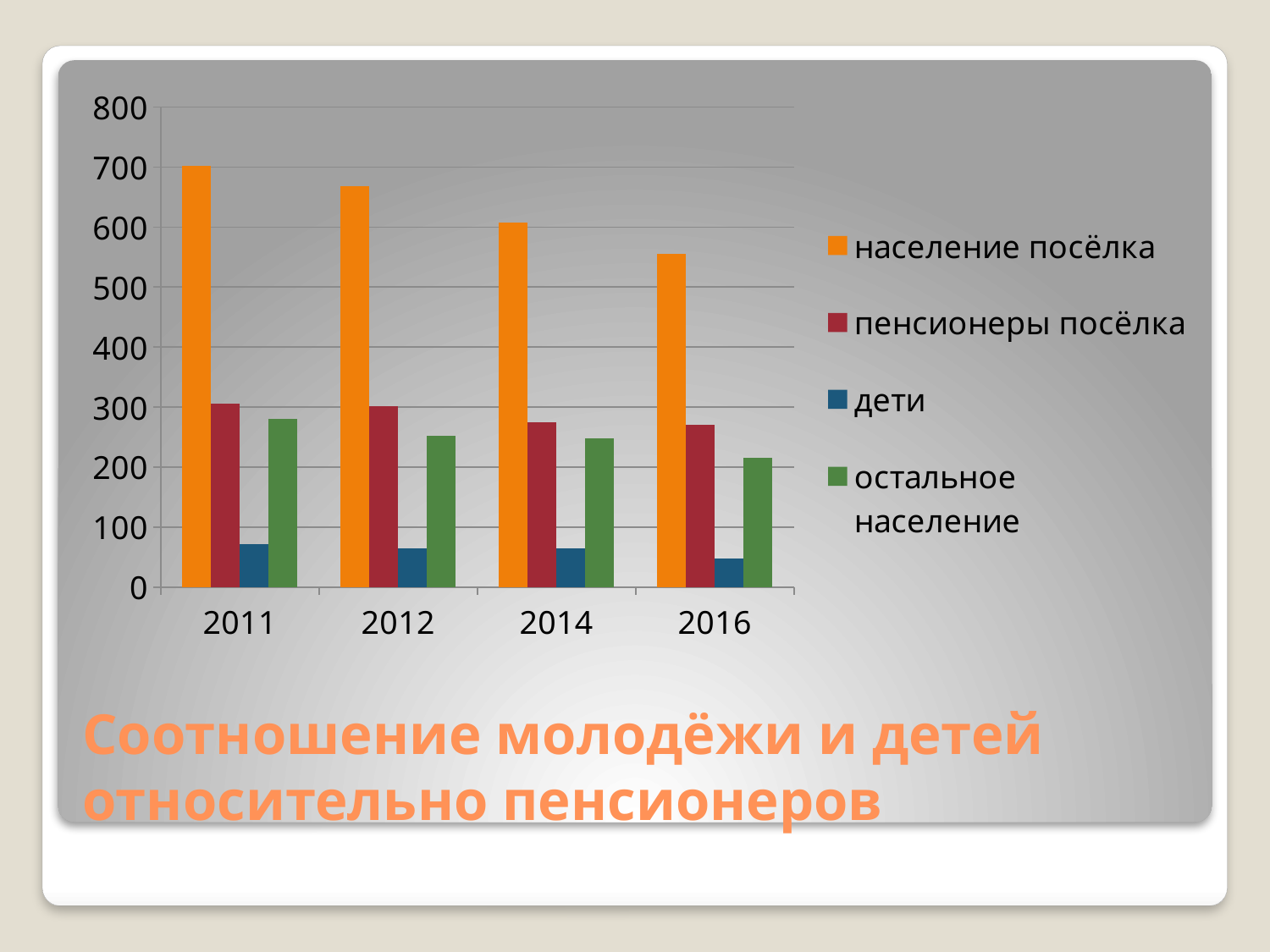
What kind of chart is shown on the slide? bar chart Is the value for дети in 2011 greater or less than 100? less Is the value for население посёлка in 2016 greater or less than 500? greater Which is larger in 2016: пенсионеры посёлка or остальное население? пенсионеры посёлка Which year has the highest value for население посёлка? 2011 How many series does the legend list? 4 What colour represents дети in the chart? blue Which year has the lowest value for дети? 2016 Is the value for пенсионеры посёлка in 2014 greater or less than 300? less How many years are shown on the x axis? 4 Does the value for население посёлка rise or fall from 2011 to 2016? fall Which year has the lowest value for население посёлка? 2016